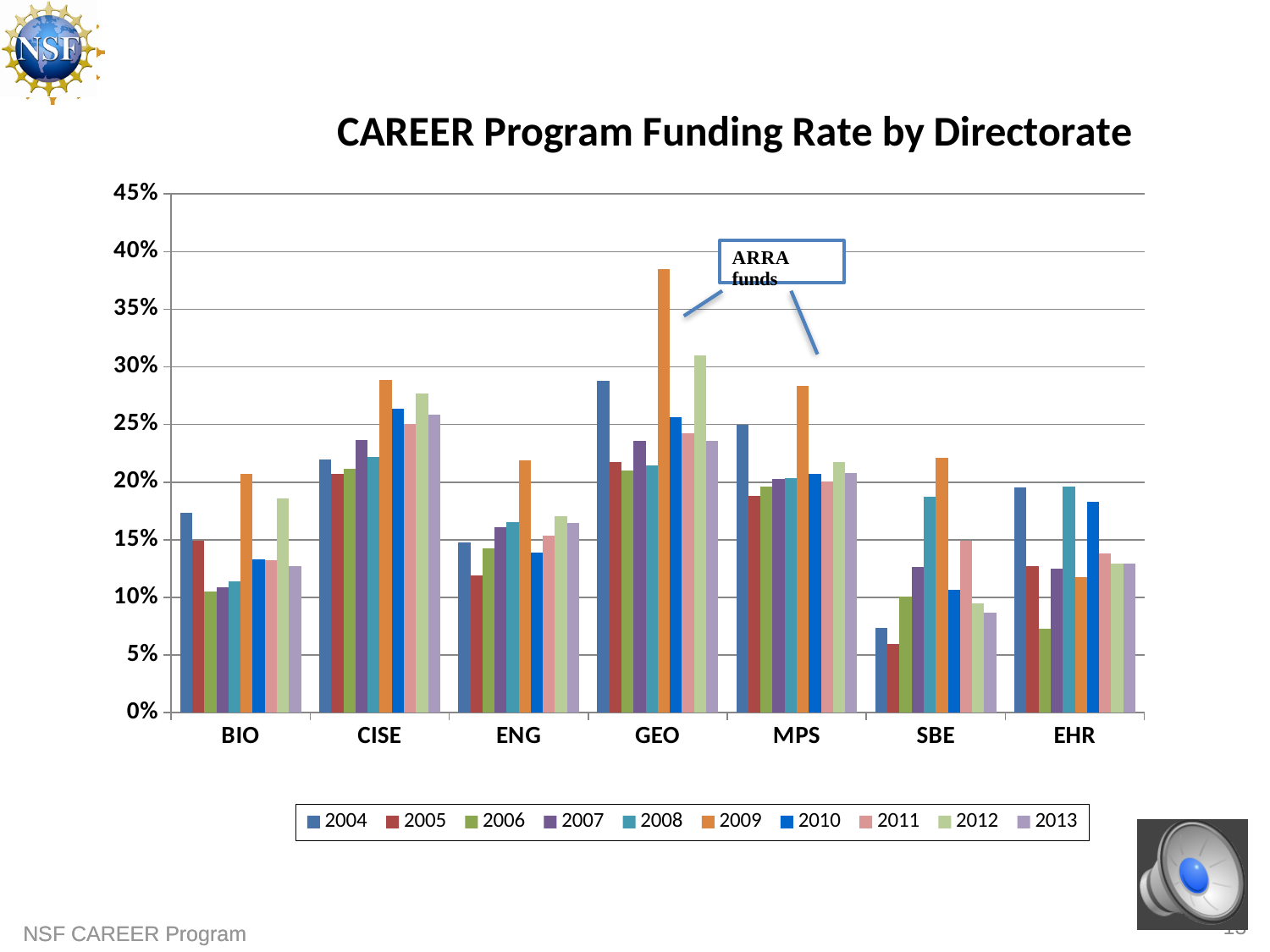
Which directorate has the highest funding rate for 2009? GEO How many directorates are shown on the x axis? 7 Is the 2009 value for MPS greater or less than 25%? greater Is the 2009 value for GEO greater or less than 35%? greater Which is larger, the 2004 value for GEO or the 2004 value for MPS? GEO Which directorate has the lowest funding rate for 2005? SBE Within SBE, which year has the highest funding rate? 2009 What kind of chart is shown on the slide? bar chart Is the 2005 value for SBE greater or less than 10%? less For BIO, which is larger, the 2009 value or the 2012 value? 2009 What is the title of the chart? CAREER Program Funding Rate by Directorate How many series does the legend list? 10